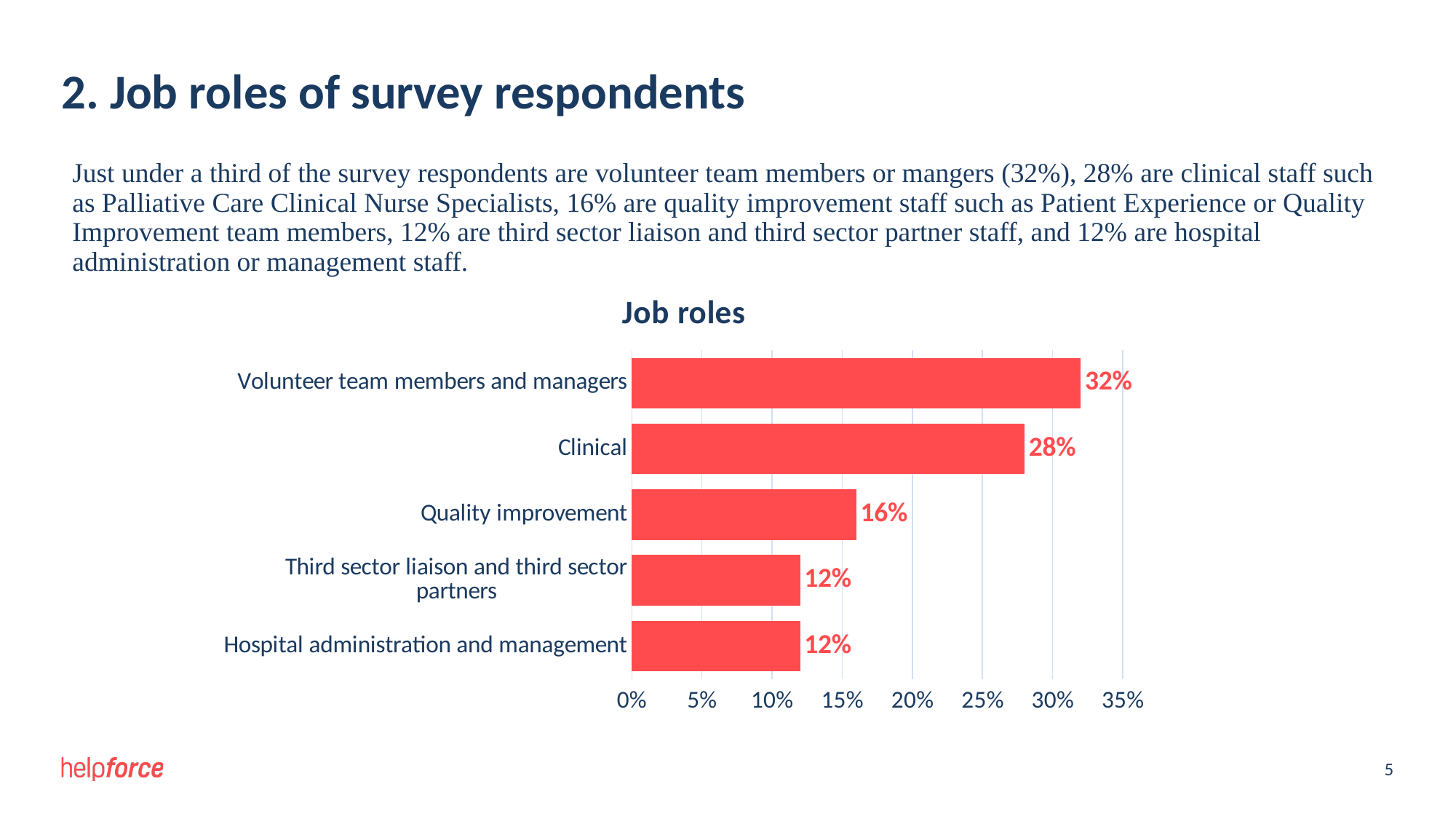
Which job role has the highest percentage of respondents? Volunteer team members and managers Is the value for Volunteer team members and managers greater or less than 30%? greater Which is larger, the value for Clinical or the value for Quality improvement? Clinical What is the highest value shown on the x axis of the chart? 35% What kind of chart is shown on the slide? bar chart What percentage of survey respondents are Clinical staff? 28% What is the value for Quality improvement? 16% What is the difference between the values for Volunteer team members and managers and Clinical? 4% What is the value for Hospital administration and management? 12% What is the difference between the values for Clinical and Quality improvement? 12% What is the title of the chart? Job roles How many job role categories are shown in the chart? 5